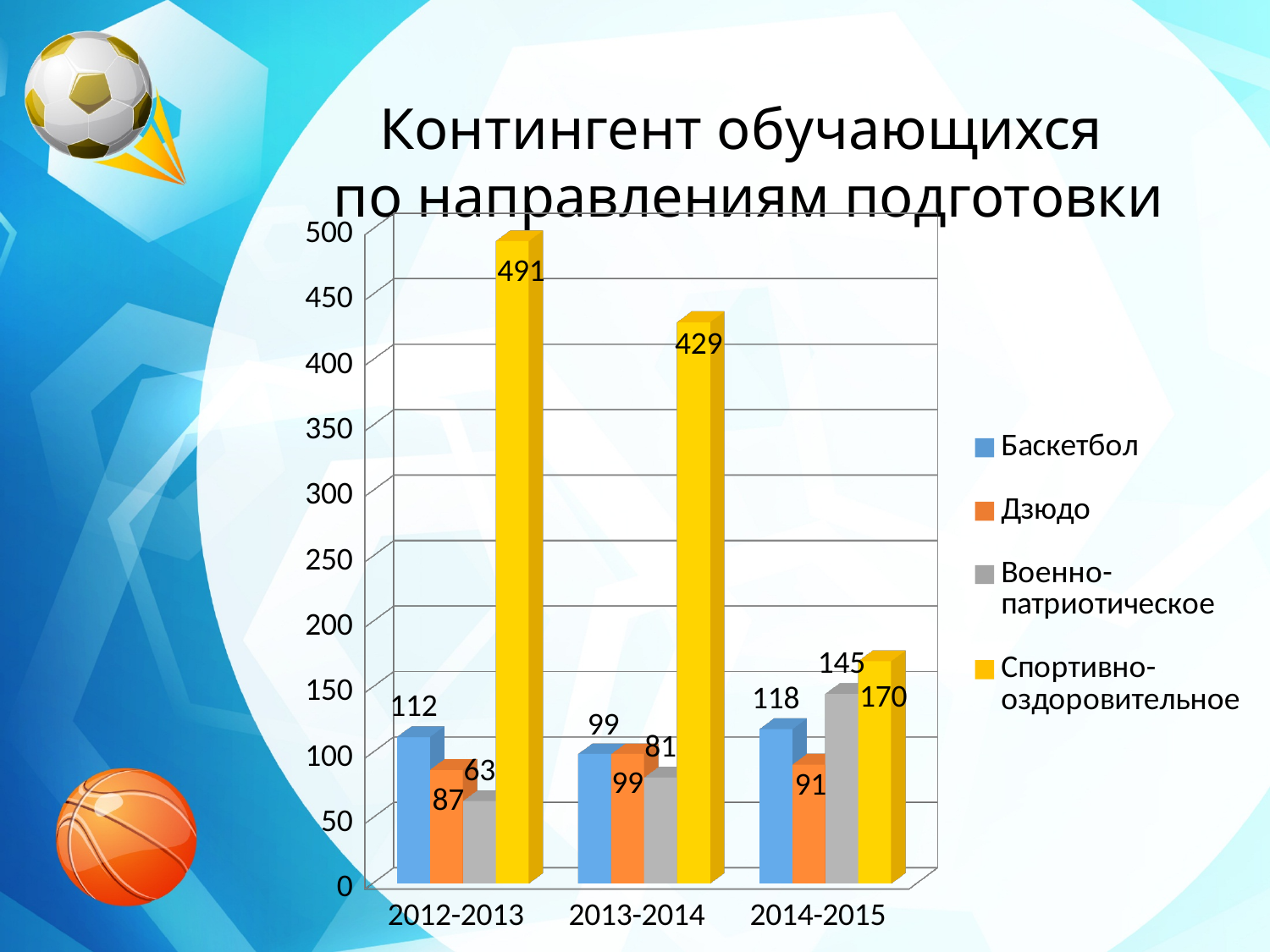
How many categories are shown on the x axis? 3 What is the difference between the Спортивно-оздоровительное values for 2012-2013 and 2013-2014? 62 Which series has the highest value in 2014-2015? Спортивно-оздоровительное What is the value for Баскетбол in 2014-2015? 118 How many series does the legend list? 4 Does the value for Спортивно-оздоровительное rise or fall from 2012-2013 to 2014-2015? Fall What is the value for Дзюдо in 2012-2013? 87 What kind of chart is shown on the slide? Bar chart Which series has the lowest value in 2012-2013? Военно-патриотическое What is the value for Военно-патриотическое in 2013-2014? 81 What is the value for Спортивно-оздоровительное in 2012-2013? 491 Which is larger: Военно-патриотическое in 2014-2015 or Дзюдо in 2014-2015? Военно-патриотическое in 2014-2015